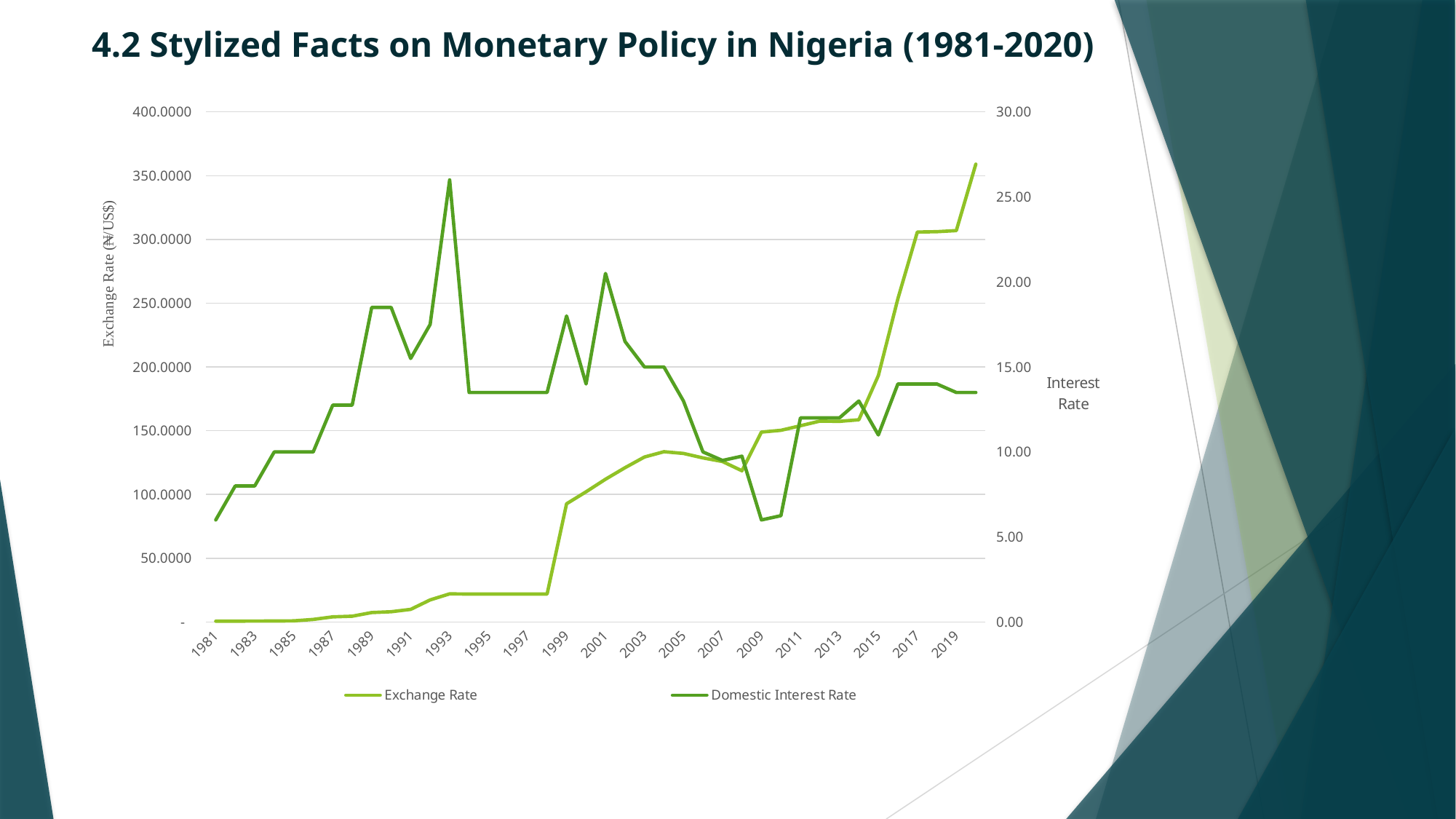
Is the Domestic Interest Rate in 1993 greater or less than 20.00? greater What are the two series named in the legend? Exchange Rate and Domestic Interest Rate How many year labels are shown on the x axis? 20 What is the label of the left vertical axis? Exchange Rate (₦/US$) Is the Exchange Rate in 2020 greater or less than 300.0000? greater In which year does the Domestic Interest Rate reach its highest value? 1993 What kind of chart is shown on the slide? line chart Does the Exchange Rate generally rise or fall from 1981 to 2020? rise How many series does the legend list? 2 In which year is the Exchange Rate at its highest? 2020 Is the Domestic Interest Rate in 2009 greater or less than 10.00? less Which is higher, the Exchange Rate in 2017 or in 2015? 2017